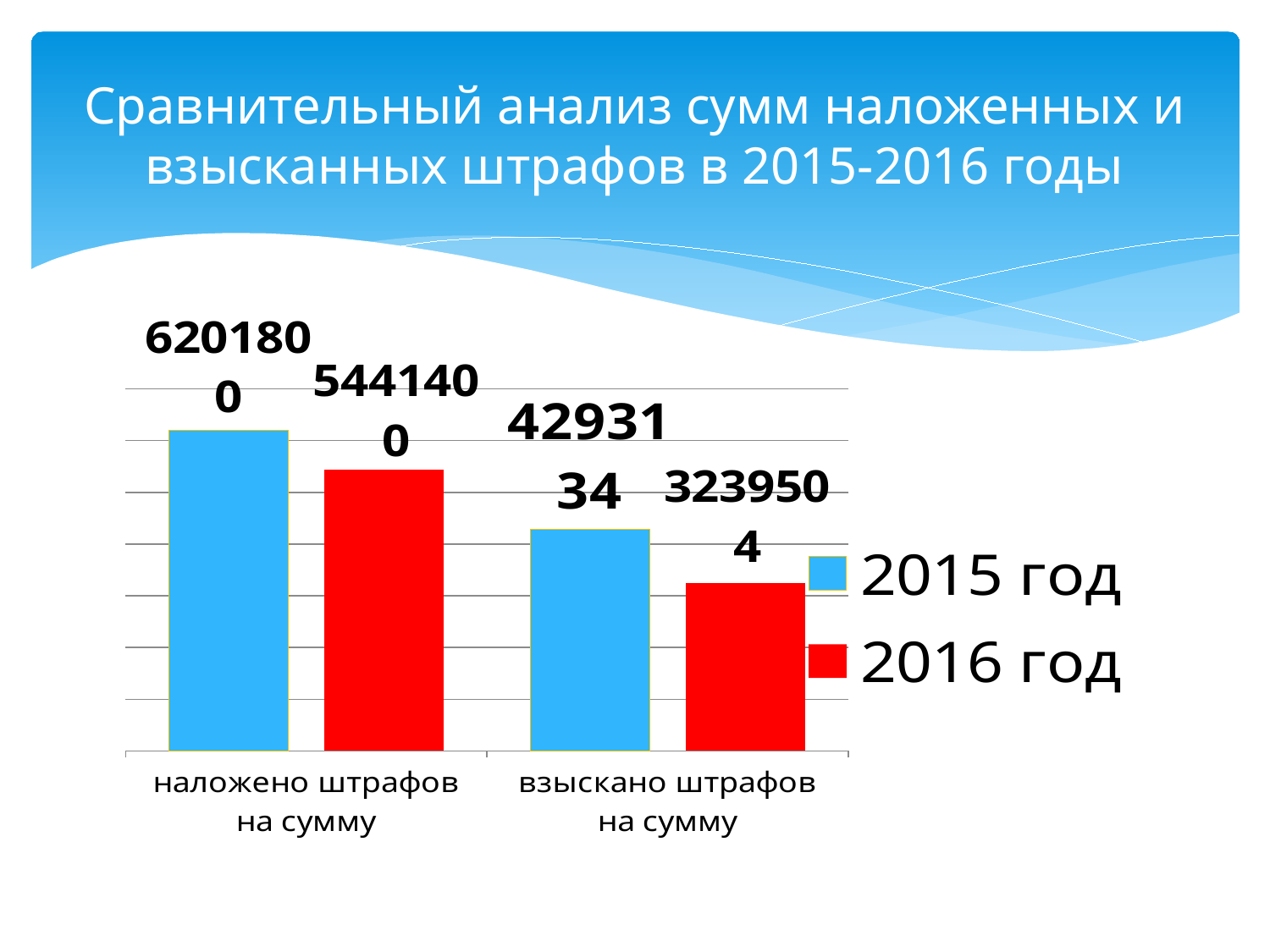
What is the value for 2016 год in the category взыскано штрафов на сумму? 3239504 How many categories are shown on the x axis? 2 What is the value for 2015 год in the category наложено штрафов на сумму? 6201800 Which bar has the lowest value on the chart? 2016 год, взыскано штрафов на сумму What is the value for 2015 год in the category взыскано штрафов на сумму? 4293134 How many series does the legend list? 2 Which bar has the highest value on the chart? 2015 год, наложено штрафов на сумму What kind of chart is shown on the slide? bar chart Which is larger for взыскано штрафов на сумму: the 2015 год value or the 2016 год value? 2015 год What is the difference between the 2015 год and 2016 год values for взыскано штрафов на сумму? 1053630 What is the value for 2016 год in the category наложено штрафов на сумму? 5441400 What is the difference between the 2015 год and 2016 год values for наложено штрафов на сумму? 760400